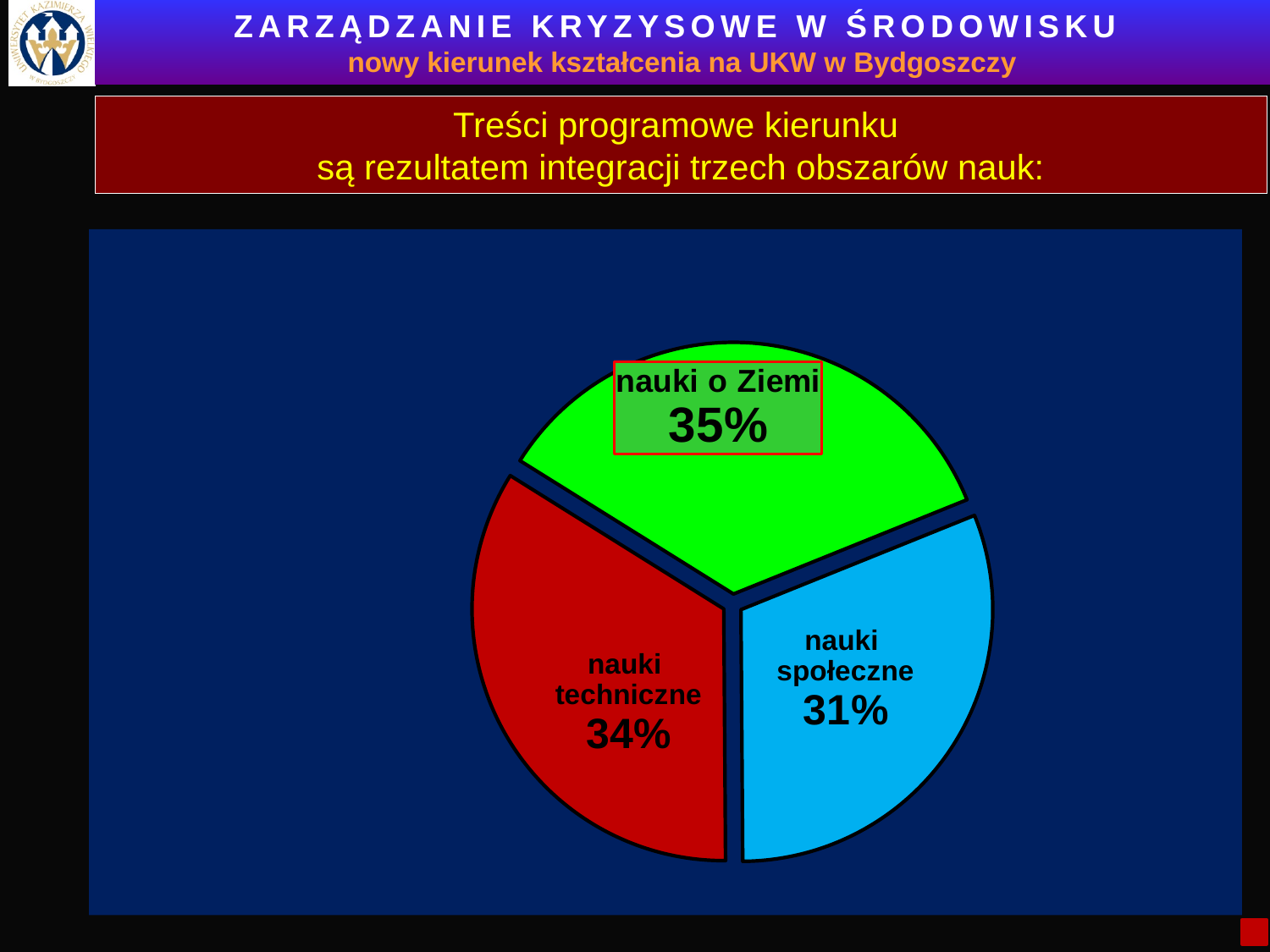
Which slice's label is enclosed in a highlighted box? nauki o Ziemi What colour is the 'nauki techniczne' slice? red What is the value shown for 'nauki społeczne'? 31% Which slice of the pie chart is the largest? nauki o Ziemi What kind of chart is shown on the slide? pie chart What share of the pie does 'nauki o Ziemi' have? 35% How many slices does the pie chart have? 3 What is the value shown for 'nauki techniczne'? 34% What is the difference in percentage points between 'nauki o Ziemi' and 'nauki społeczne'? 4 Which is larger, the share for 'nauki techniczne' or the share for 'nauki społeczne'? nauki techniczne What is the difference in percentage points between 'nauki techniczne' and 'nauki społeczne'? 3 Which slice of the pie chart is the smallest? nauki społeczne